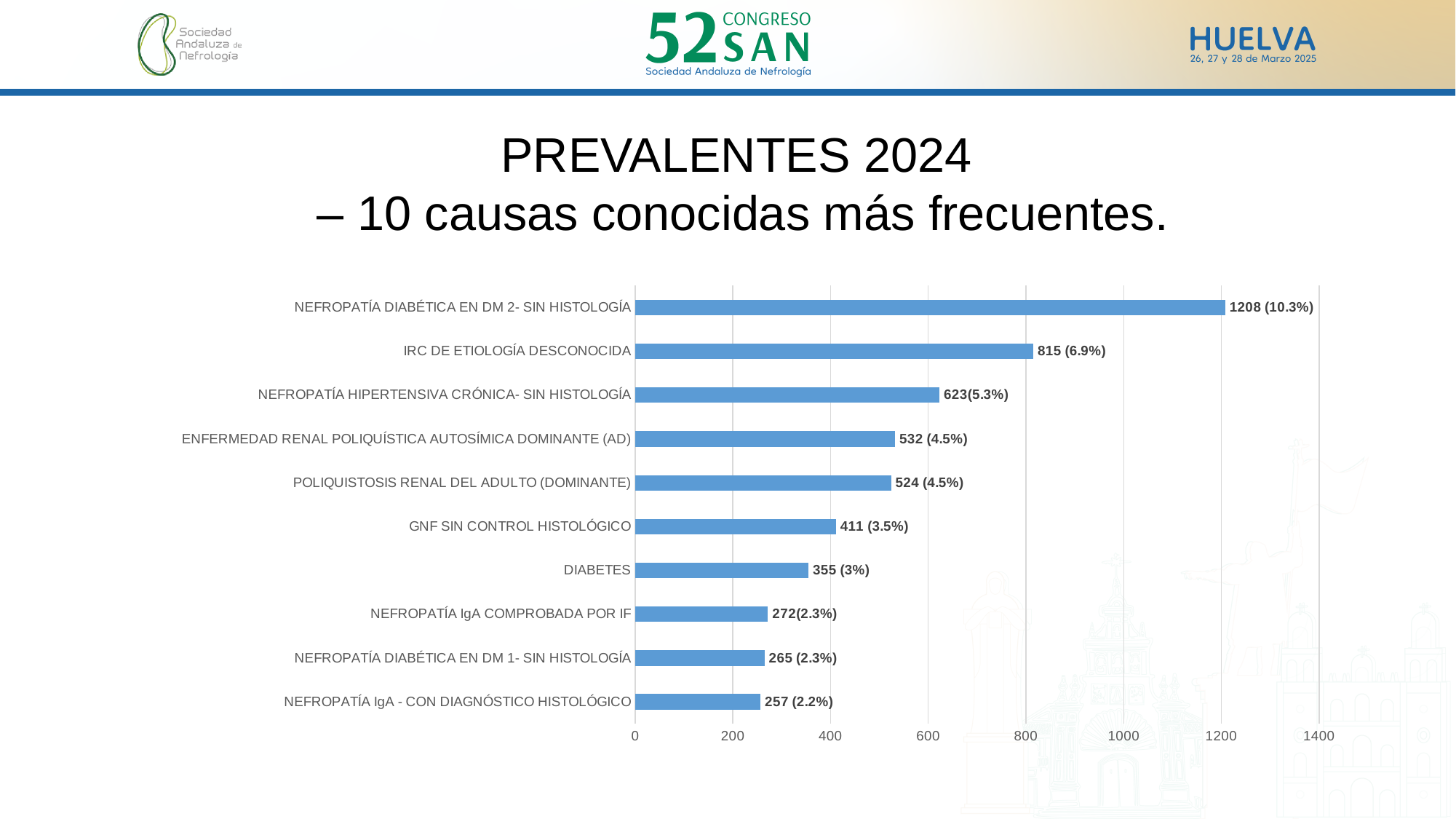
What is the difference between the counts for NEFROPATÍA DIABÉTICA EN DM 2- SIN HISTOLOGÍA and IRC DE ETIOLOGÍA DESCONOCIDA? 393 Which has a larger count, NEFROPATÍA HIPERTENSIVA CRÓNICA- SIN HISTOLOGÍA or GNF SIN CONTROL HISTOLÓGICO? NEFROPATÍA HIPERTENSIVA CRÓNICA- SIN HISTOLOGÍA Which category has the highest value? NEFROPATÍA DIABÉTICA EN DM 2- SIN HISTOLOGÍA What is the value shown for NEFROPATÍA DIABÉTICA EN DM 2- SIN HISTOLOGÍA? 1208 (10.3%) What is the value shown for IRC DE ETIOLOGÍA DESCONOCIDA? 815 (6.9%) What kind of chart is shown on the slide? Bar chart How many categories are shown in the chart? 10 What is the difference between the counts for ENFERMEDAD RENAL POLIQUÍSTICA AUTOSÍMICA DOMINANTE (AD) and POLIQUISTOSIS RENAL DEL ADULTO (DOMINANTE)? 8 What is the value shown for DIABETES? 355 (3%) Is the value for IRC DE ETIOLOGÍA DESCONOCIDA greater or less than 800? greater Which category has the lowest value? NEFROPATÍA IgA - CON DIAGNÓSTICO HISTOLÓGICO What is the value shown for GNF SIN CONTROL HISTOLÓGICO? 411 (3.5%)